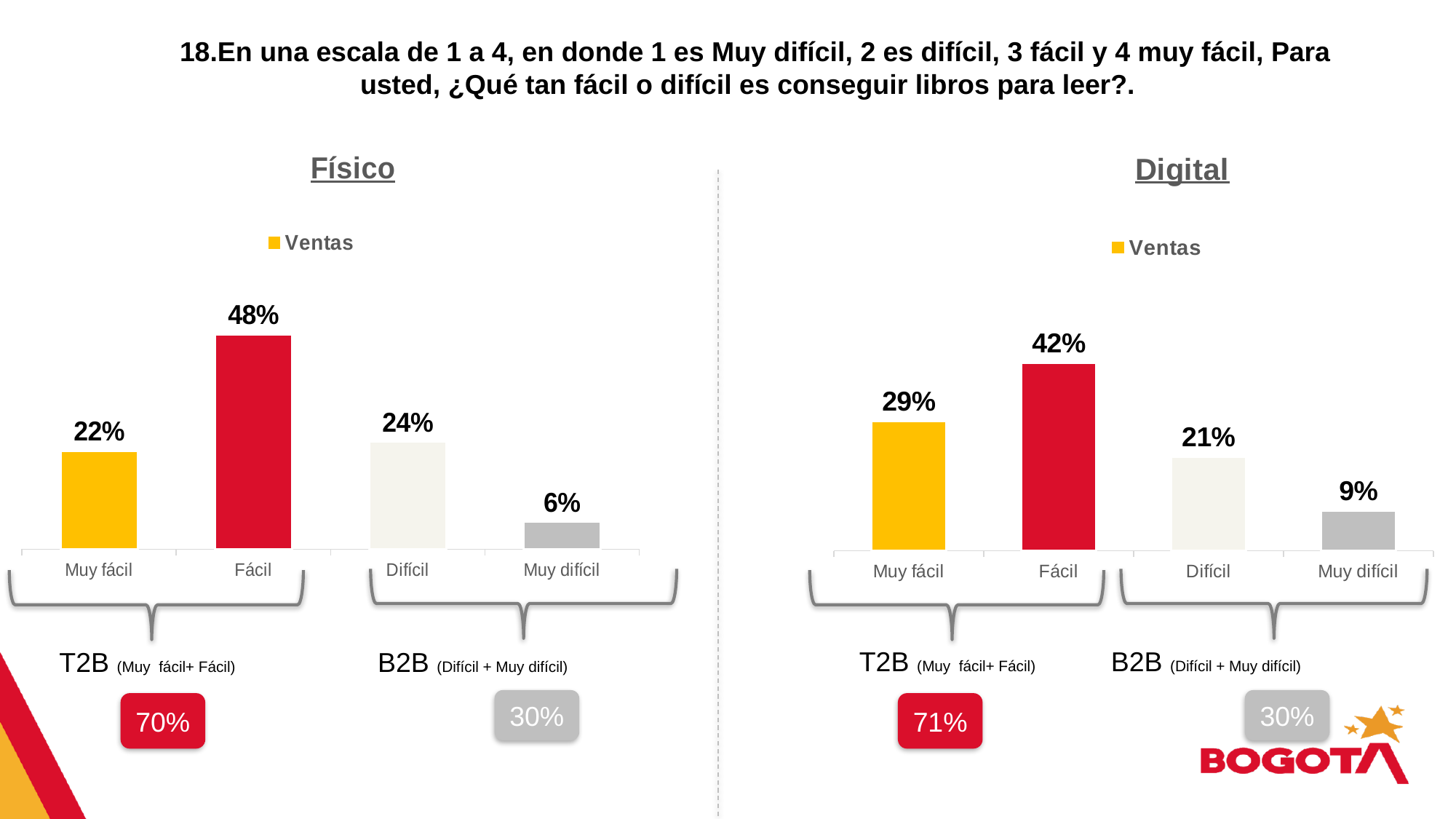
In the Físico chart, what is the total of Muy fácil and Fácil (T2B)? 70% In the Físico chart, what is the difference between the values for Fácil and Difícil? 24% In the Físico chart, which category has the lowest value? Muy difícil In the Físico chart, what is the value for Fácil? 48% In the Digital chart, which category has the highest value? Fácil In the Físico chart, how many categories are shown on the x axis? 4 In the Digital chart, which is larger, the value for Muy fácil or the value for Difícil? Muy fácil In the Digital chart, how many series does the legend list? 1 In the Digital chart, what is the value for Muy fácil? 29% In the Digital chart, what is the difference between the values for Fácil and Muy fácil? 13% What is the name of the series in the legend of the Digital chart? Ventas What kind of chart is the Físico chart? Bar chart